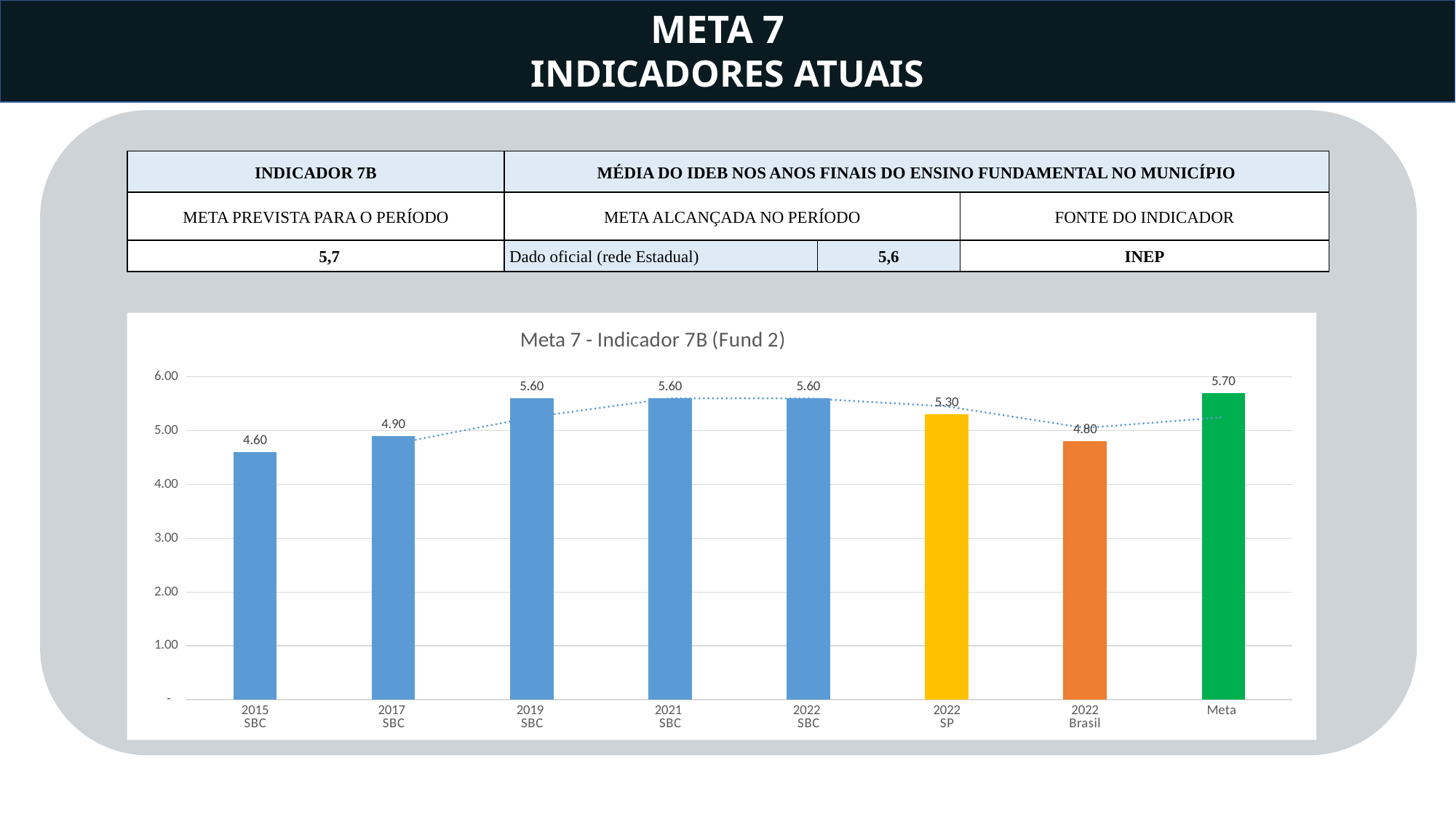
How many bars are shown in the chart? 8 What is the difference between the Meta value and the 2022 SBC value? 0.10 What is the difference between the 2022 SP value and the 2022 Brasil value? 0.50 What is the title of the chart? Meta 7 - Indicador 7B (Fund 2) What is the value for 2015 SBC? 4.60 What kind of chart is this? bar chart Which category has the highest value? Meta Which category has the lowest value? 2015 SBC What is the value for 2022 Brasil? 4.80 What is the value for 2022 SP? 5.30 Which is larger, the value for 2022 SBC or the value for 2022 SP? 2022 SBC What is the value for Meta? 5.70